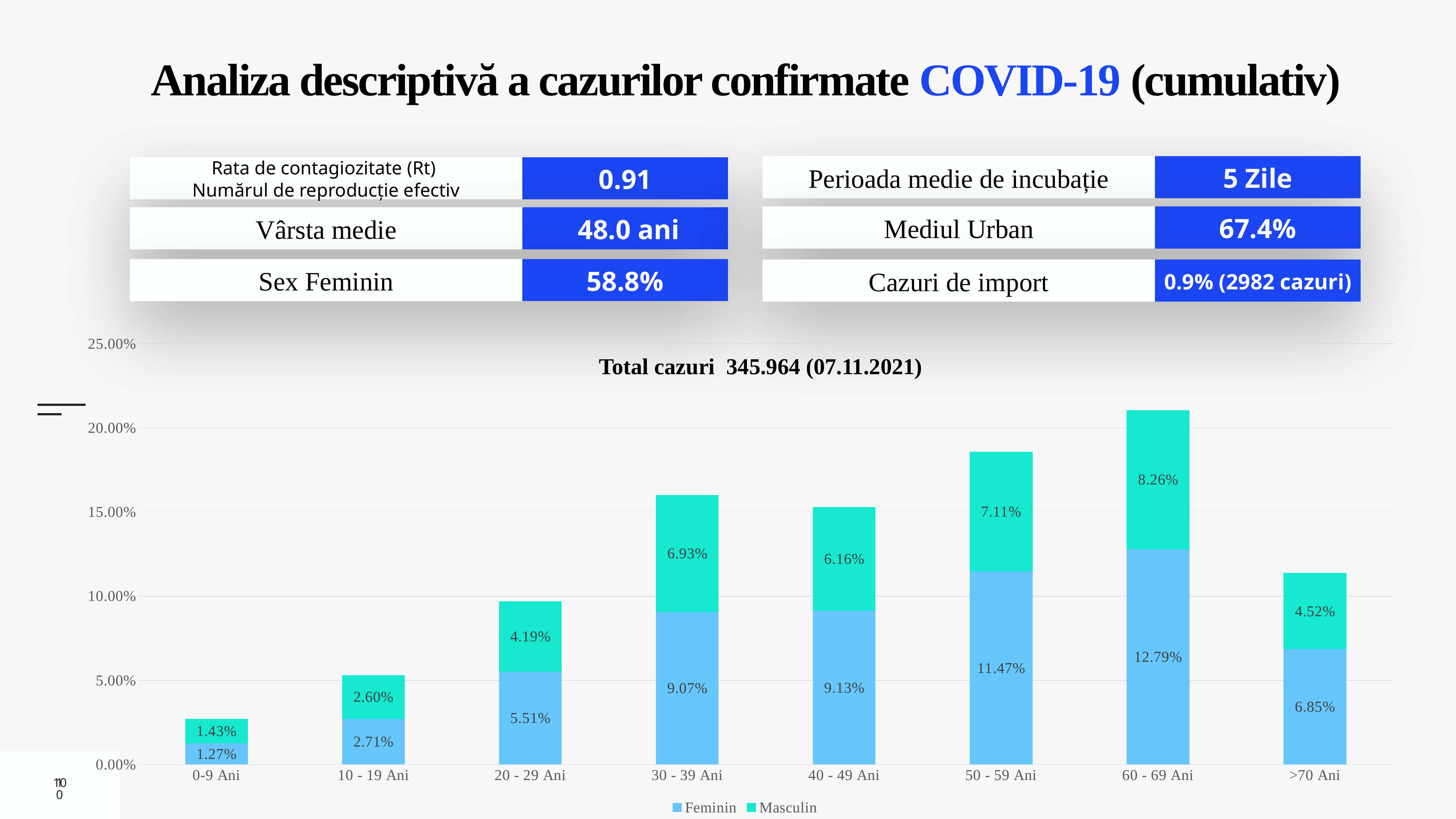
What is the total of the stacked bar for the 60 - 69 Ani age group? 21.05% What is the Feminin value for the 60 - 69 Ani age group? 12.79% What is the Feminin value for the 0-9 Ani age group? 1.27% What is the Masculin value for the 30 - 39 Ani age group? 6.93% What kind of chart is shown on the slide? Stacked bar chart Which age group has the highest Feminin value? 60 - 69 Ani Which age group has the lowest Masculin value? 0-9 Ani What is the total of the stacked bar for the 0-9 Ani age group? 2.70% What is the difference between the Feminin and Masculin values for the 50 - 59 Ani age group? 4.36% How many series does the chart legend list? 2 How many age groups are shown on the x axis of the chart? 8 Which is larger for the 20 - 29 Ani age group, the Feminin value or the Masculin value? Feminin